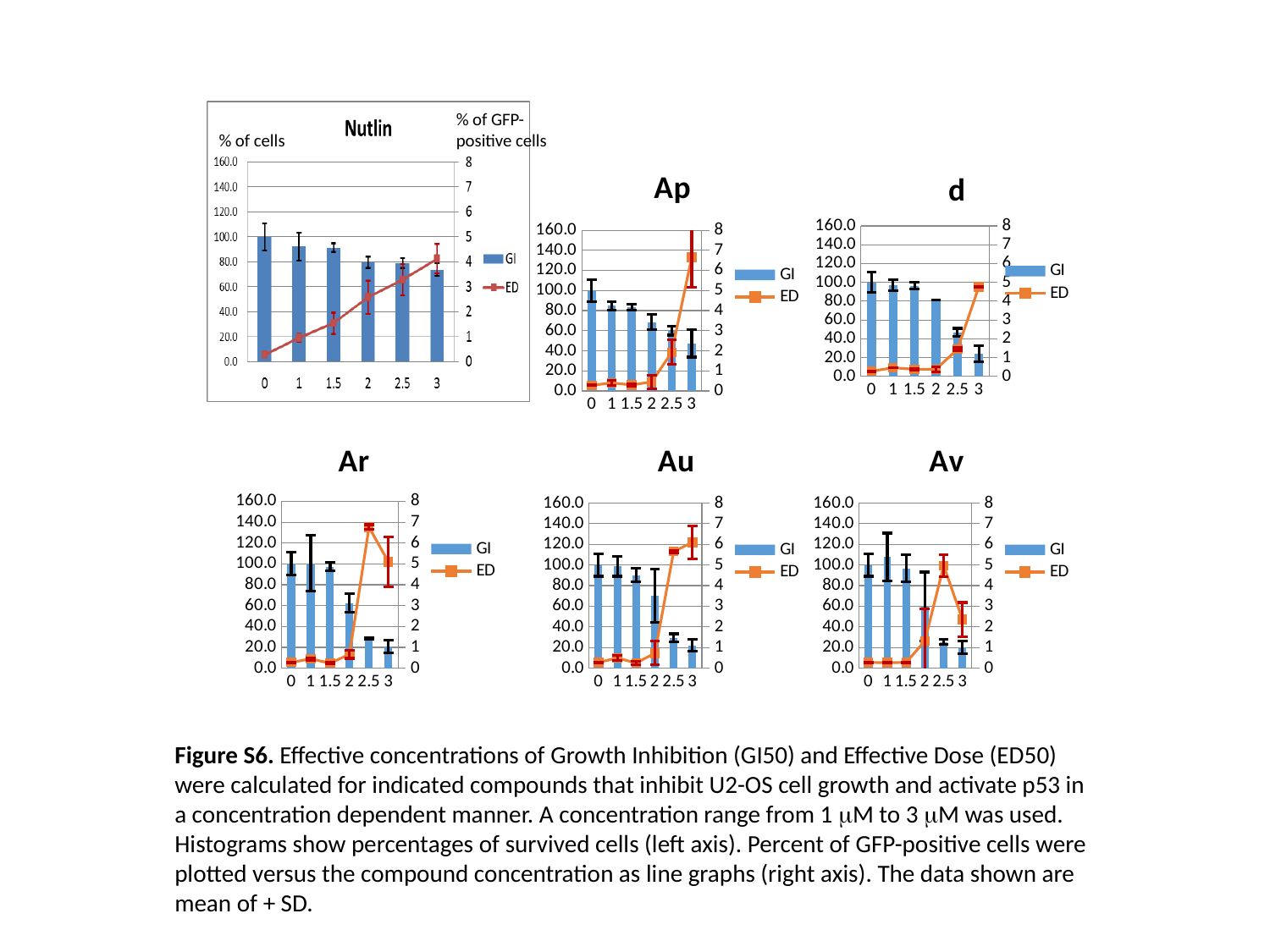
How many concentration categories are shown on the x axis of the Ap chart? 6 How many series does the legend of the Nutlin chart list? 2 What is the label of the left vertical axis on the Nutlin chart? % of cells In the d chart, is the GI value at concentration 3 greater or less than 40? less In the Ap chart, is the GI value at concentration 0 greater or less than 80? greater In the Av chart, is the GI value at concentration 2.5 greater or less than 40? less In the Ap chart, do the GI bars generally rise or fall as concentration increases along the x axis? fall What kind of chart is the Nutlin chart? bar and line chart In the Ar chart, at which concentration is the ED value highest? 2.5 In the Au chart, at which concentration is the GI bar lowest? 3 In the Nutlin chart, does the ED line rise or fall as concentration increases along the x axis? rise